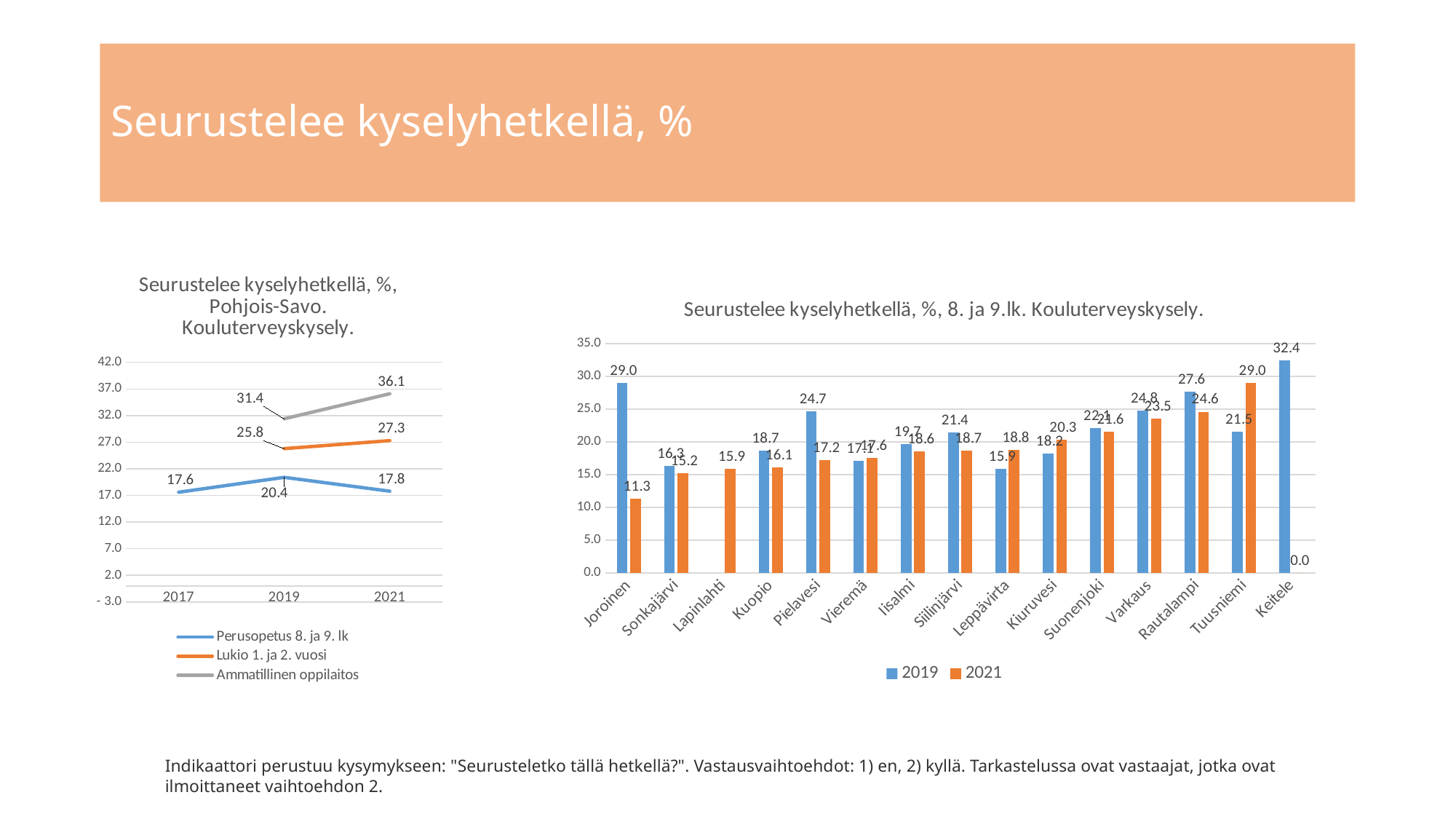
How many series does the legend of the line chart on the left list? 3 How many municipalities are shown on the x axis of the bar chart on the right? 15 In the bar chart on the right, what is the 2021 value for Tuusniemi? 29.0 How many series does the legend of the bar chart on the right list? 2 In the bar chart on the right, what is the 2019 value for Joroinen? 29.0 In the line chart on the left, what is the value for Ammatillinen oppilaitos in 2021? 36.1 In the bar chart on the right, which municipality has the highest 2019 value? Keitele In the bar chart on the right, what is the difference between the 2019 and 2021 values for Joroinen? 17.7 In the line chart on the left, what is the value for Perusopetus 8. ja 9. lk in 2019? 20.4 In the bar chart on the right, is the 2019 or the 2021 value larger for Pielavesi? 2019 What kind of chart is the chart on the right? bar chart In the bar chart on the right, which municipality has the lowest 2019 value? Leppävirta